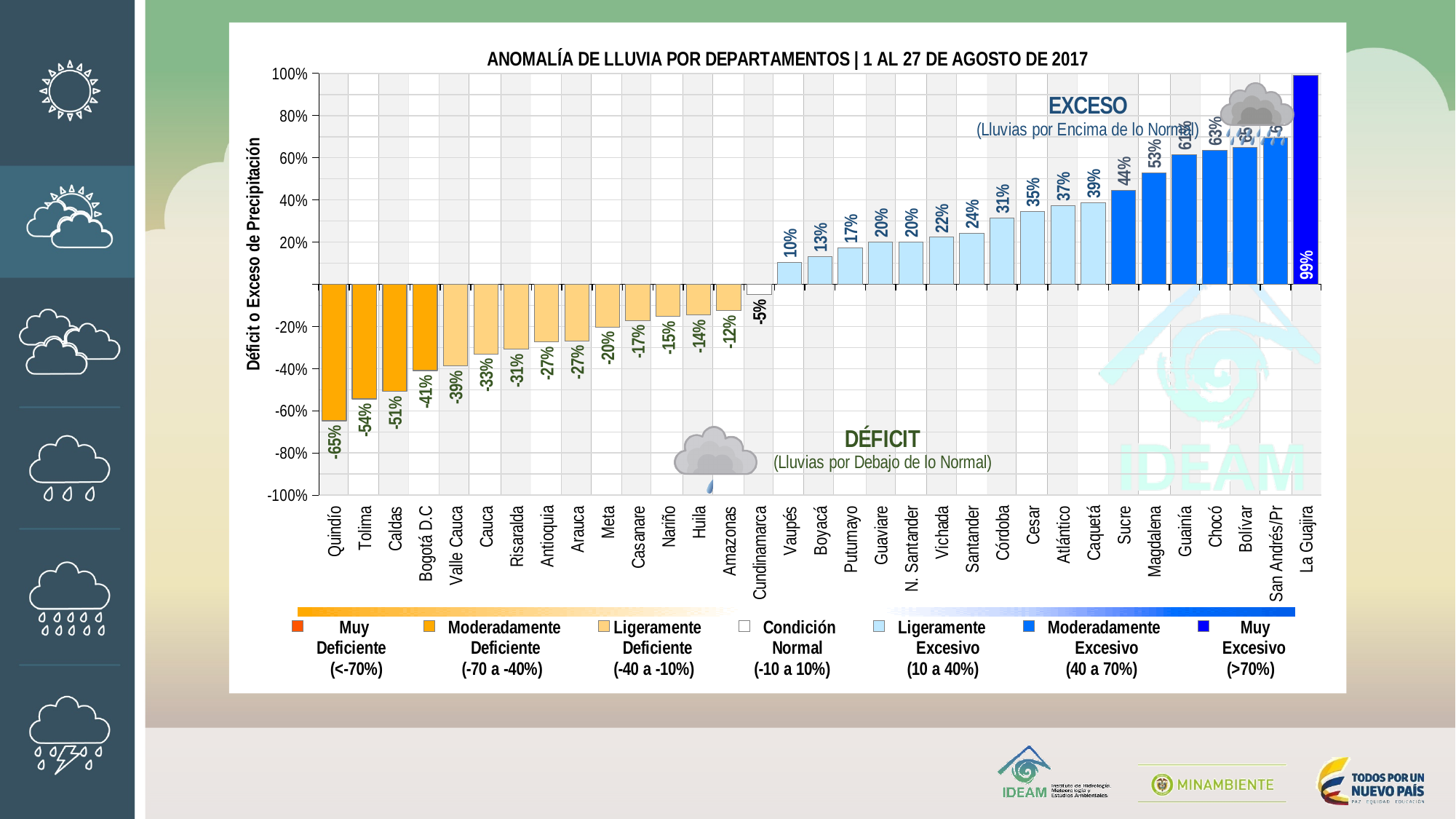
What is the rainfall anomaly value shown for Quindío? -65% What is the rainfall anomaly value shown for Cundinamarca? -5% Which has the larger rainfall anomaly value, Cesar or Córdoba? Cesar Do the values rise or fall moving from left to right along the x axis? Rise What is the rainfall anomaly value shown for La Guajira? 99% How many departments are shown on the x axis of the chart? 33 What kind of chart is shown on the slide? Bar chart What is the difference between the values for Caldas and Tolima? 3 percentage points Is the value for Magdalena greater or less than 40%? greater Which department has the lowest rainfall anomaly value? Quindío What is the rainfall anomaly value shown for Santander? 24% Which department has the highest rainfall anomaly value? La Guajira